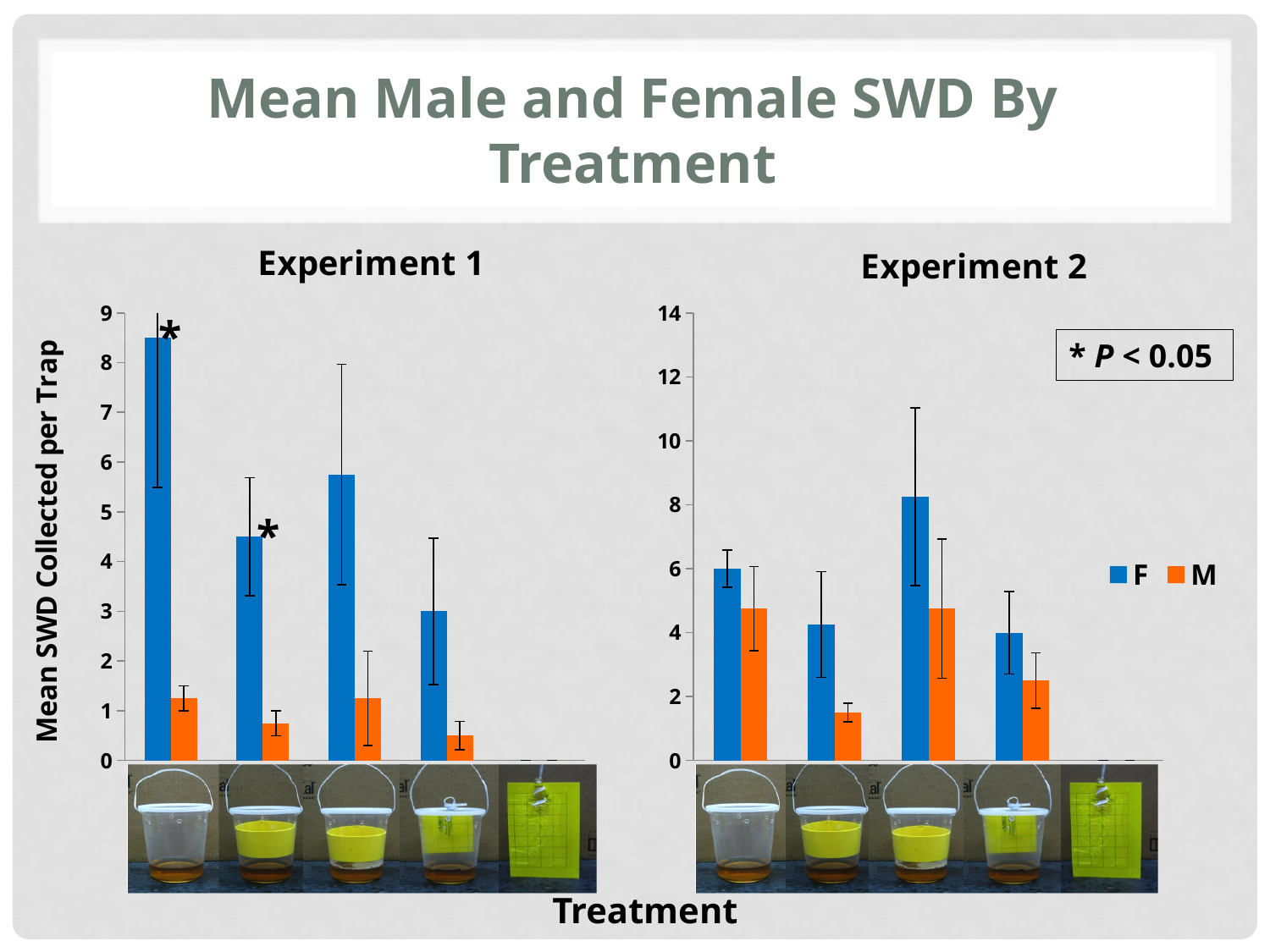
What is the y-axis title of the Experiment 1 chart? Mean SWD Collected per Trap In the Experiment 2 chart, is the M value for the second treatment greater or less than 2? less In the Experiment 1 chart, which treatment position has the highest F bar? the first In the Experiment 2 chart, which treatment position has the highest F bar? the third In the Experiment 2 chart, is the F value for the third treatment greater or less than 6? greater What kind of chart is used for Experiment 1? bar chart In the Experiment 1 chart, is the F value for the fourth treatment greater or less than 4? less What are the two series named in the legend? F and M How many series does the legend list? 2 In the Experiment 2 chart, for the first treatment, which is larger, the F bar or the M bar? F